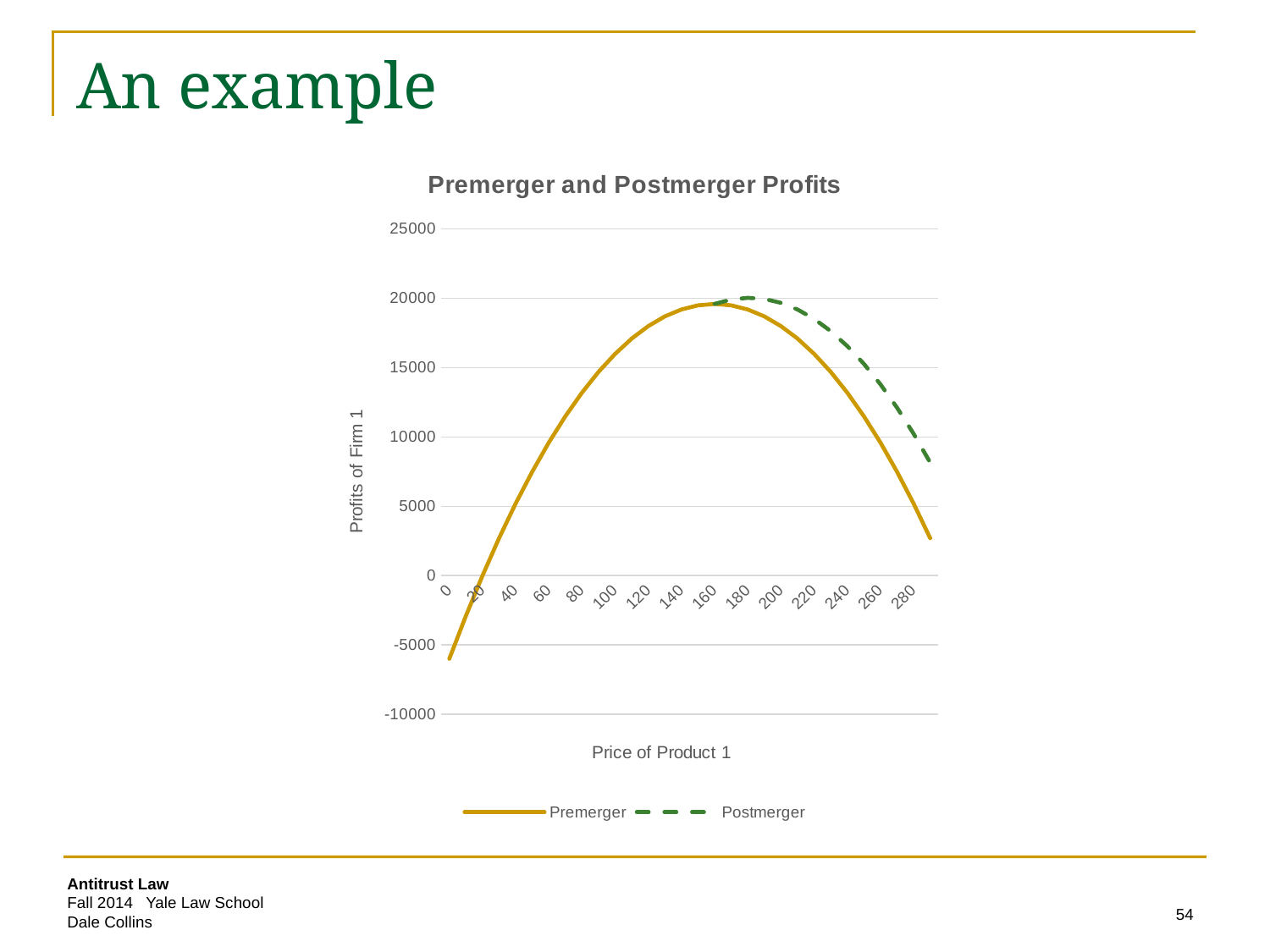
What kind of chart is shown on the slide? line chart What is the label of the vertical axis? Profits of Firm 1 Does the Premerger profit rise or fall as the price increases from 0 to 120? rise Does the Postmerger profit rise or fall as the price increases from 200 to 280? fall Is the Premerger profit at a price of 80 greater or less than 10000? greater What is the title of the chart? Premerger and Postmerger Profits Is the Postmerger profit at a price of 280 greater or less than 5000? greater Is the Premerger profit at a price of 0 greater or less than 0? less At a price of 280, which series shows the higher profit, Premerger or Postmerger? Postmerger How many series does the legend list? 2